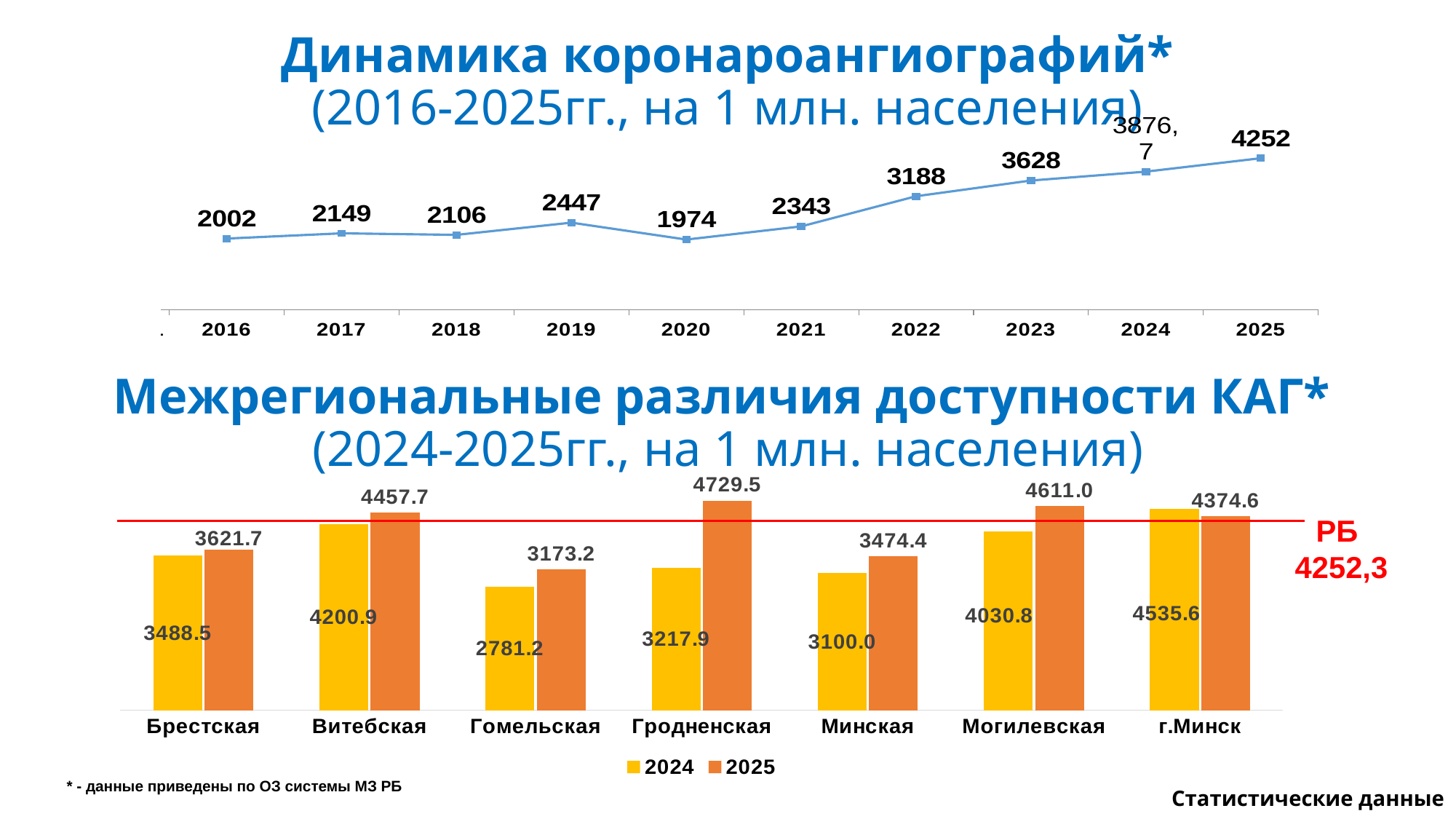
In the bottom bar chart (Межрегиональные различия доступности КАГ), which region has the lowest 2024 value? Гомельская In the bottom bar chart (Межрегиональные различия доступности КАГ), what is the 2025 value for Гродненская? 4729.5 In the top line chart (Динамика коронароангиографий), how many years are plotted? 10 In the top line chart (Динамика коронароангиографий), what is the value for 2020? 1974 In the top line chart (Динамика коронароангиографий), do the values generally rise or fall from 2021 to 2025? rise In the top line chart (Динамика коронароангиографий), which year has the lowest value? 2020 In the top line chart (Динамика коронароангиографий), what is the difference between the 2025 value and the 2016 value? 2250 What type of chart is the bottom chart (Межрегиональные различия доступности КАГ)? bar chart In the top line chart (Динамика коронароангиографий), which year has the highest value? 2025 In the bottom bar chart (Межрегиональные различия доступности КАГ), how many series does the legend list? 2 In the bottom bar chart (Межрегиональные различия доступности КАГ), which is larger for г.Минск: the 2024 value or the 2025 value? 2024 In the bottom bar chart (Межрегиональные различия доступности КАГ), what is the difference between the 2025 and 2024 values for Гродненская? 1511.6